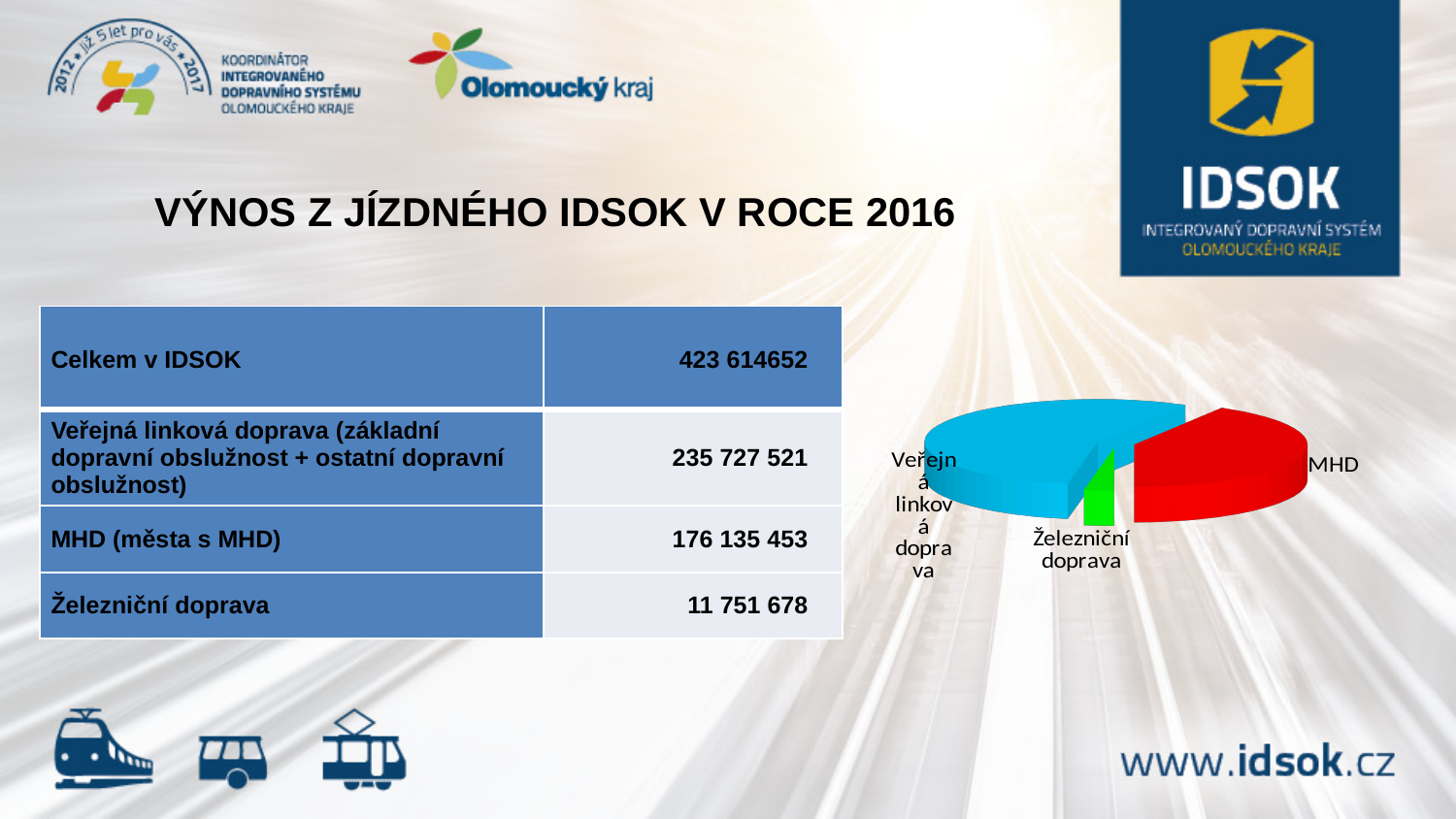
Which slice is larger, MHD or Železniční doprava? MHD According to the table, what is the value for Veřejná linková doprava? 235 727 521 Which category has the smallest slice in the pie chart? Železniční doprava What is the difference between the values for Veřejná linková doprava and MHD? 59 592 068 What is the total value for Celkem v IDSOK shown in the table? 423 614652 What kind of chart is shown on the slide? pie chart According to the table, what is the value for MHD (města s MHD)? 176 135 453 Which category has the largest slice in the pie chart? Veřejná linková doprava According to the table, what is the value for Železniční doprava? 11 751 678 How many slices does the pie chart have? 3 What is the title of the slide above the chart and table? VÝNOS Z JÍZDNÉHO IDSOK V ROCE 2016 What colour is the MHD slice in the pie chart? red